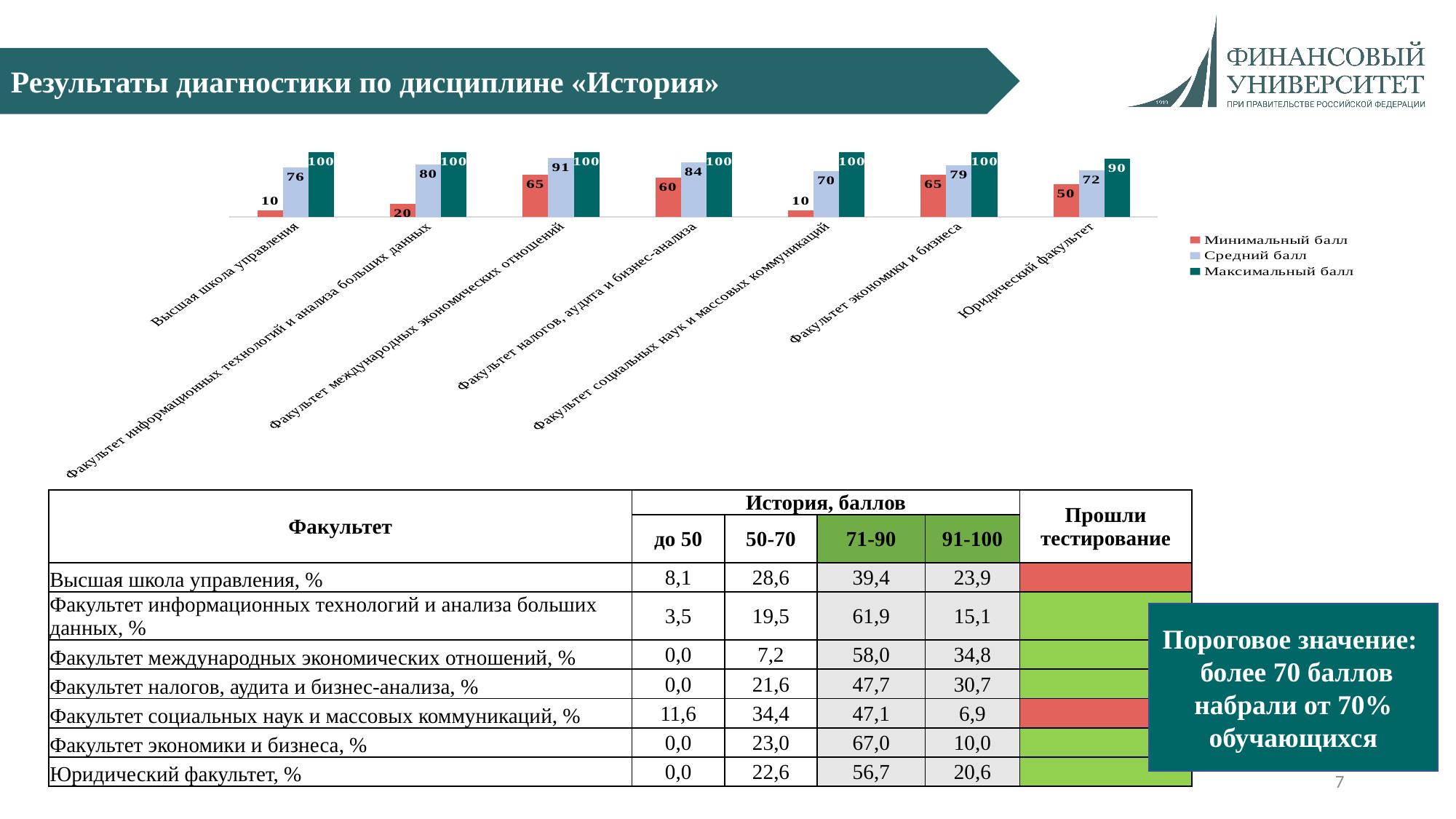
Which faculty has the lowest Максимальный балл? Юридический факультет What is the Средний балл for Факультет международных экономических отношений? 91 How many series does the chart legend list? 3 Which is larger: the Средний балл for Факультет налогов, аудита и бизнес-анализа or for Факультет экономики и бизнеса? Факультет налогов, аудита и бизнес-анализа What is the difference between the Средний балл and the Минимальный балл for Высшая школа управления? 66 Which faculty has the highest Средний балл? Факультет международных экономических отношений Which faculty has the lowest Средний балл? Факультет социальных наук и массовых коммуникаций How many faculties are shown on the chart? 7 What is the Минимальный балл for Юридический факультет? 50 What is the Максимальный балл for Юридический факультет? 90 Which series is shown in red on the chart? Минимальный балл What type of chart is shown on the slide? Bar chart